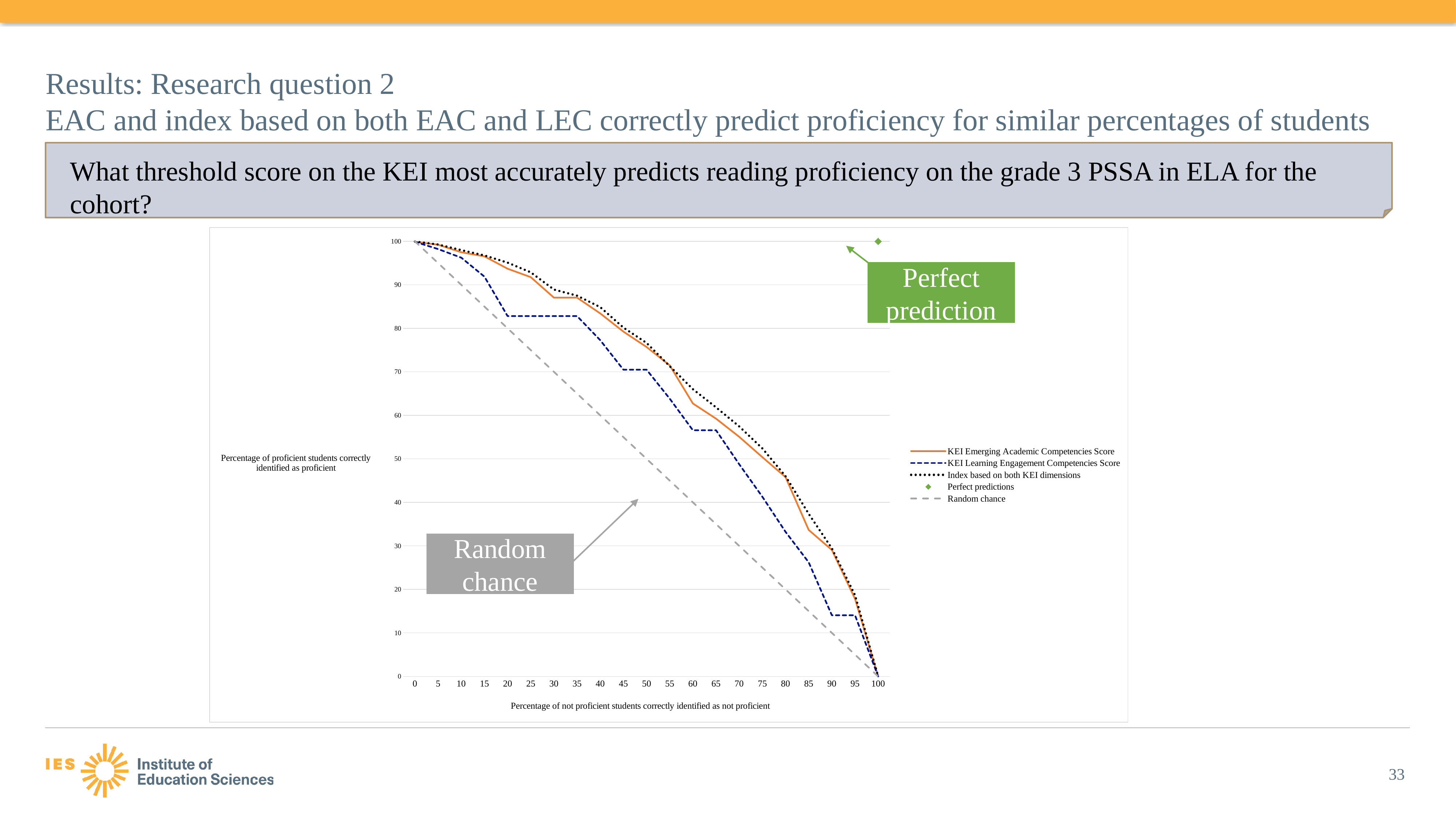
Is the value of the KEI Learning Engagement Competencies Score series at x = 90 greater or less than 20? less At x = 65, which series has the higher value: Index based on both KEI dimensions or Random chance? Index based on both KEI dimensions Is the value of the KEI Learning Engagement Competencies Score series at x = 20 greater or less than 80? greater What is the title of the chart's y axis? Percentage of proficient students correctly identified as proficient Is the value of the KEI Emerging Academic Competencies Score series at x = 30 greater or less than 80? greater What kind of chart is shown on the slide? line chart Do the values of the KEI Emerging Academic Competencies Score series rise or fall as the x axis increases? fall How many series does the chart legend list? 5 At x = 20, which series has the higher value: KEI Emerging Academic Competencies Score or KEI Learning Engagement Competencies Score? KEI Emerging Academic Competencies Score What is the title of the chart's x axis? Percentage of not proficient students correctly identified as not proficient At what y-axis value is the Perfect predictions marker plotted? 100